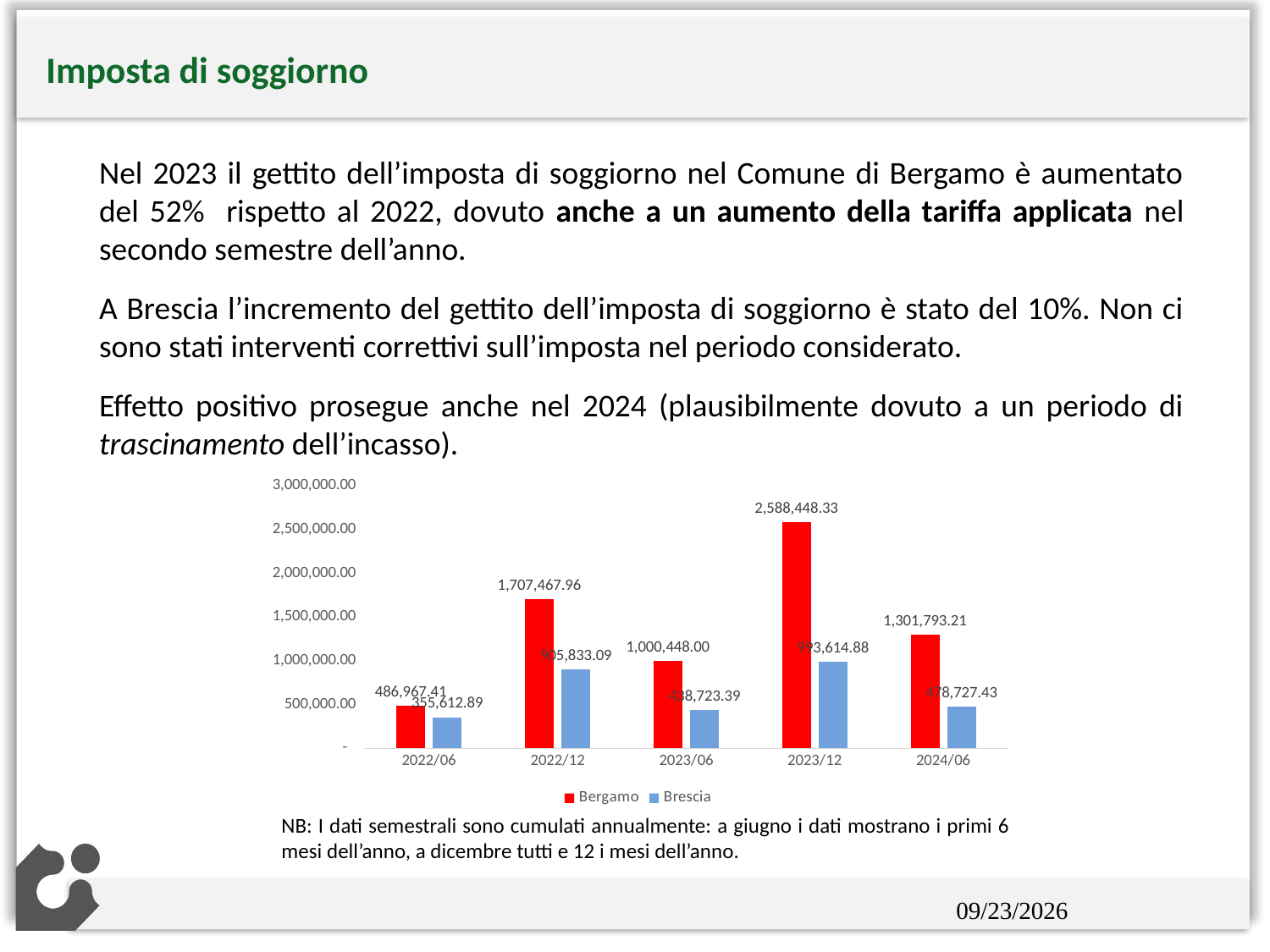
In which period is the Bergamo value lowest? 2022/06 What is the value for Bergamo at 2023/12? 2,588,448.33 What is the difference between the Bergamo and Brescia values at 2022/06? 131,354.52 Is the value for Brescia at 2023/12 greater or less than 1,000,000.00? less In which period is the Bergamo value highest? 2023/12 Which is larger for Bergamo: the value at 2023/06 or at 2024/06? 2024/06 What kind of chart is shown on the slide? bar chart How many series does the legend list? 2 What is the value for Bergamo at 2024/06? 1,301,793.21 What is the value for Bergamo at 2022/12? 1,707,467.96 How many periods are shown on the x axis? 5 What is the value for Brescia at 2022/06? 355,612.89